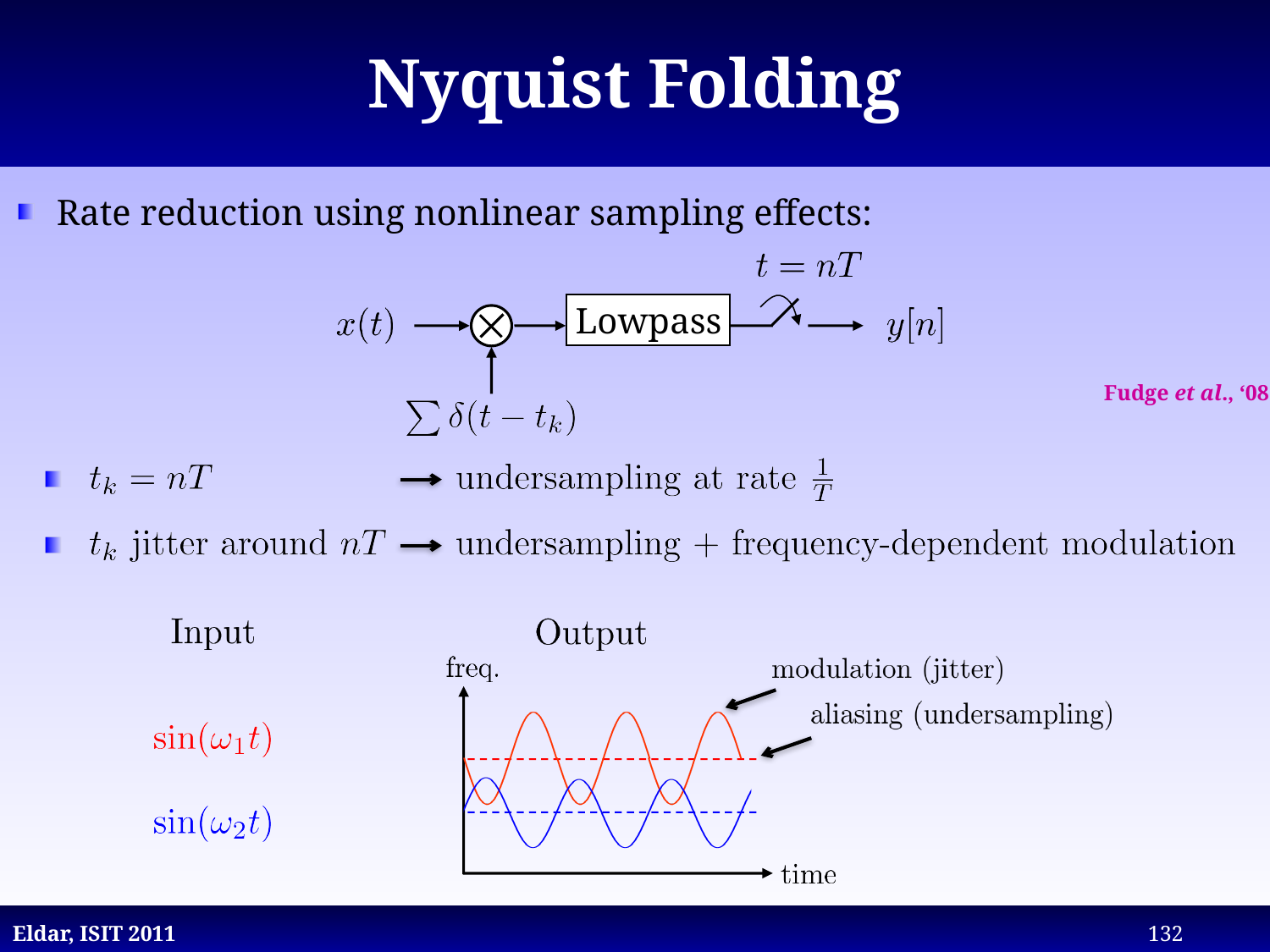
In the Output plot, what effect is the dashed line labelled as representing? aliasing (undersampling) How many sinusoidal curves are drawn in the Output plot? 2 What label is on the vertical axis of the Output plot? freq. Which input signal corresponds to the red curve in the Output plot? sin(ω1 t) In the Output plot, which curve has the higher dashed baseline, the red one or the blue one? red What kind of chart is the Output plot? line chart In the Output plot, what effect is the oscillating curve labelled as representing? modulation (jitter) What label is on the horizontal axis of the Output plot? time Which input signal corresponds to the blue curve in the Output plot? sin(ω2 t)